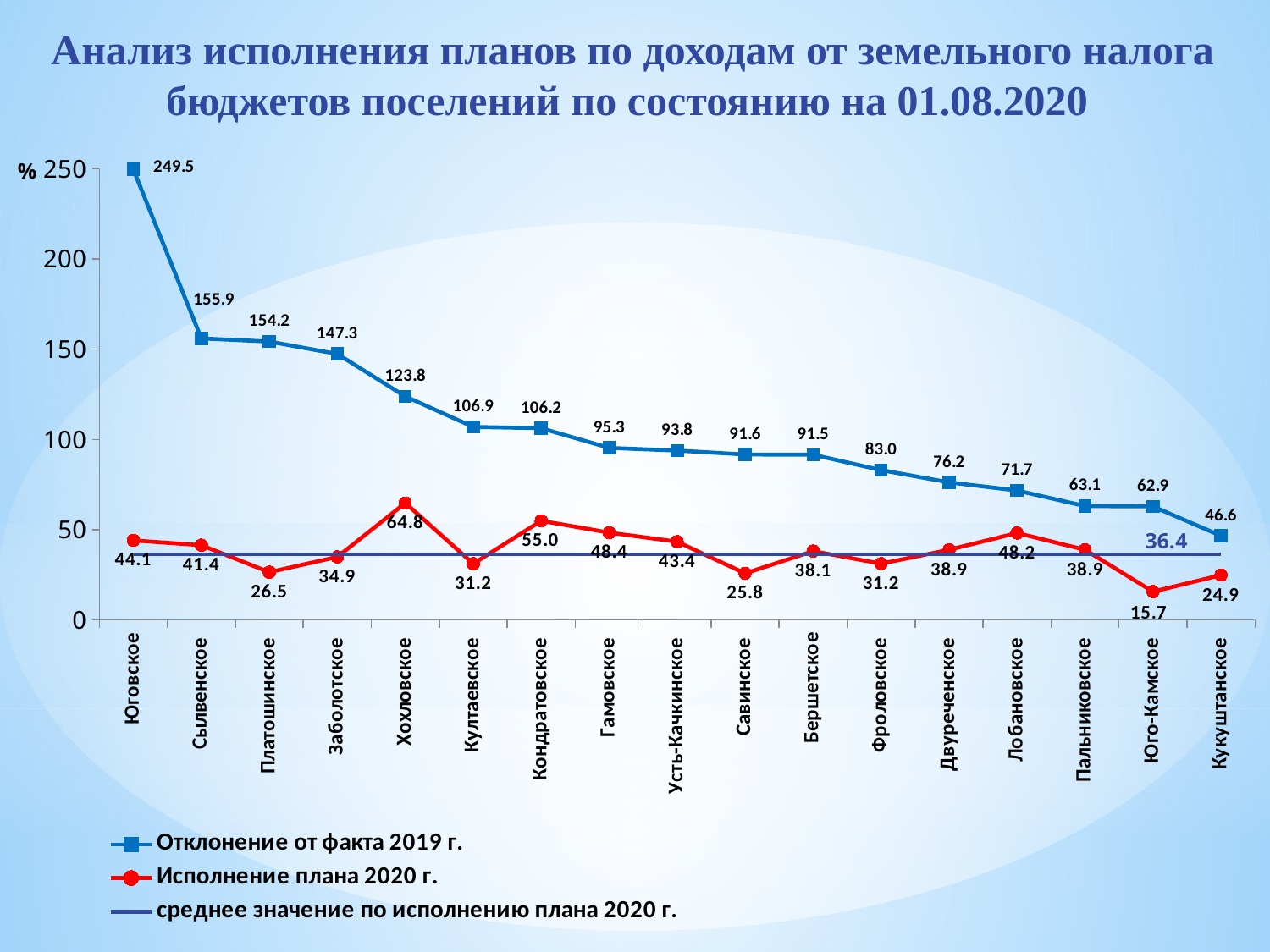
How many series does the legend list? 3 Which settlement has the highest value in the 'Исполнение плана 2020 г.' series? Хохловское What is the value of the 'среднее значение по исполнению плана 2020 г.' line? 36.4 What is the difference between the 'Отклонение от факта 2019 г.' values for Юговское and Кукуштанское? 202.9 In the 'Исполнение плана 2020 г.' series, which is larger: Кондратовское or Гамовское? Кондратовское What is the value of the 'Отклонение от факта 2019 г.' series for Юговское? 249.5 What is the value of the 'Исполнение плана 2020 г.' series for Хохловское? 64.8 What kind of chart is shown on the slide? Line chart What is the value of the 'Отклонение от факта 2019 г.' series for Кукуштанское? 46.6 Which settlement has the lowest value in the 'Исполнение плана 2020 г.' series? Юго-Камское Does the 'Отклонение от факта 2019 г.' series rise or fall from left to right along the x axis? Fall How many settlements are shown on the x axis? 17